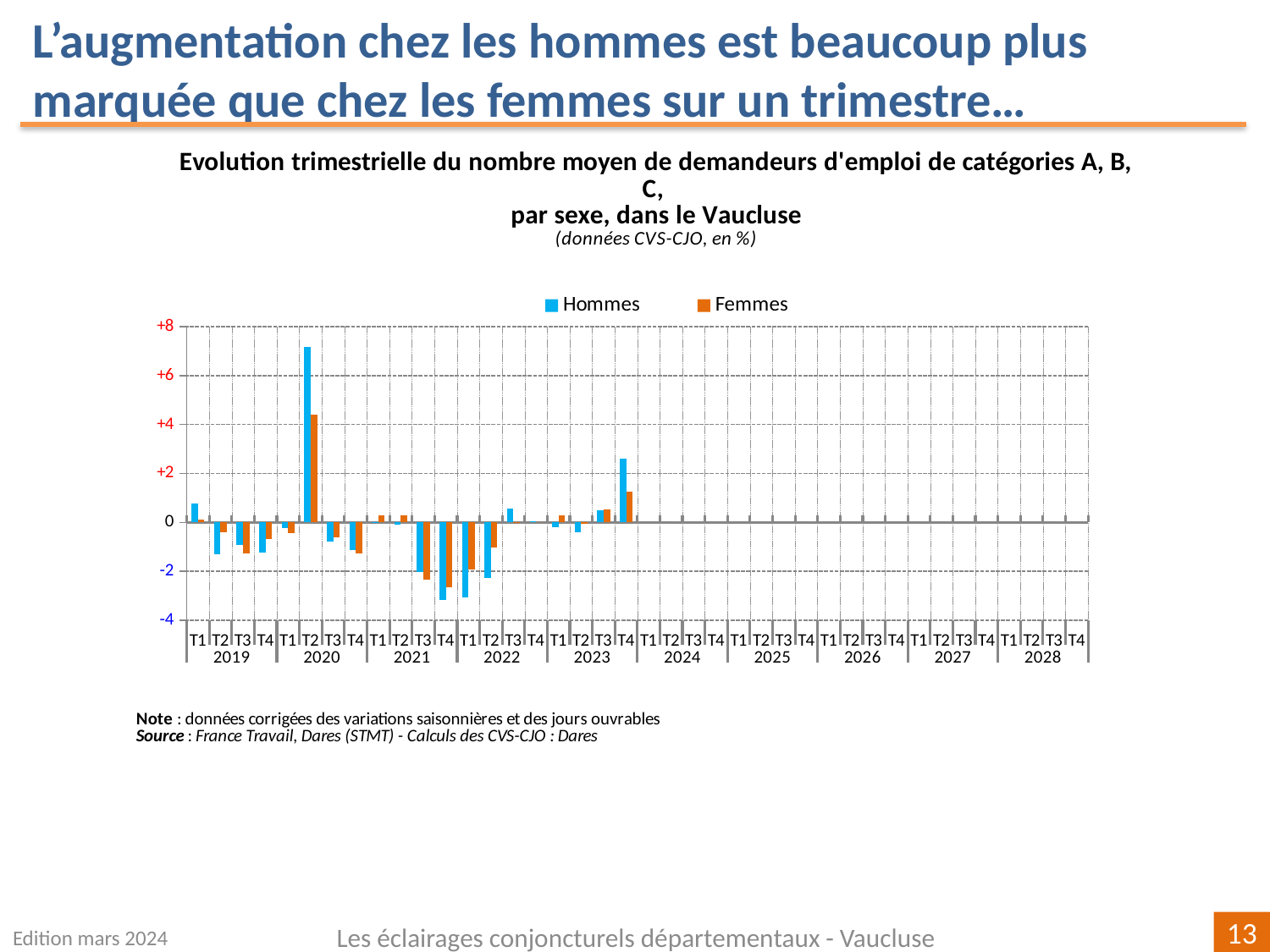
Is the Hommes value for T4 2021 greater or less than -2? less How many series does the legend list? 2 Is the Hommes value for T2 2020 greater or less than +6? greater Is the Hommes value for T4 2023 greater or less than +2? greater How many years are labelled along the x axis? 10 In which quarter does the Hommes series reach its highest value? T2 2020 What are the two series named in the legend? Hommes and Femmes In T2 2020, which series has the larger value, Hommes or Femmes? Hommes What colour are the bars for the Hommes series? blue What kind of chart is shown on the slide? bar chart In T4 2023, which series has the larger value, Hommes or Femmes? Hommes